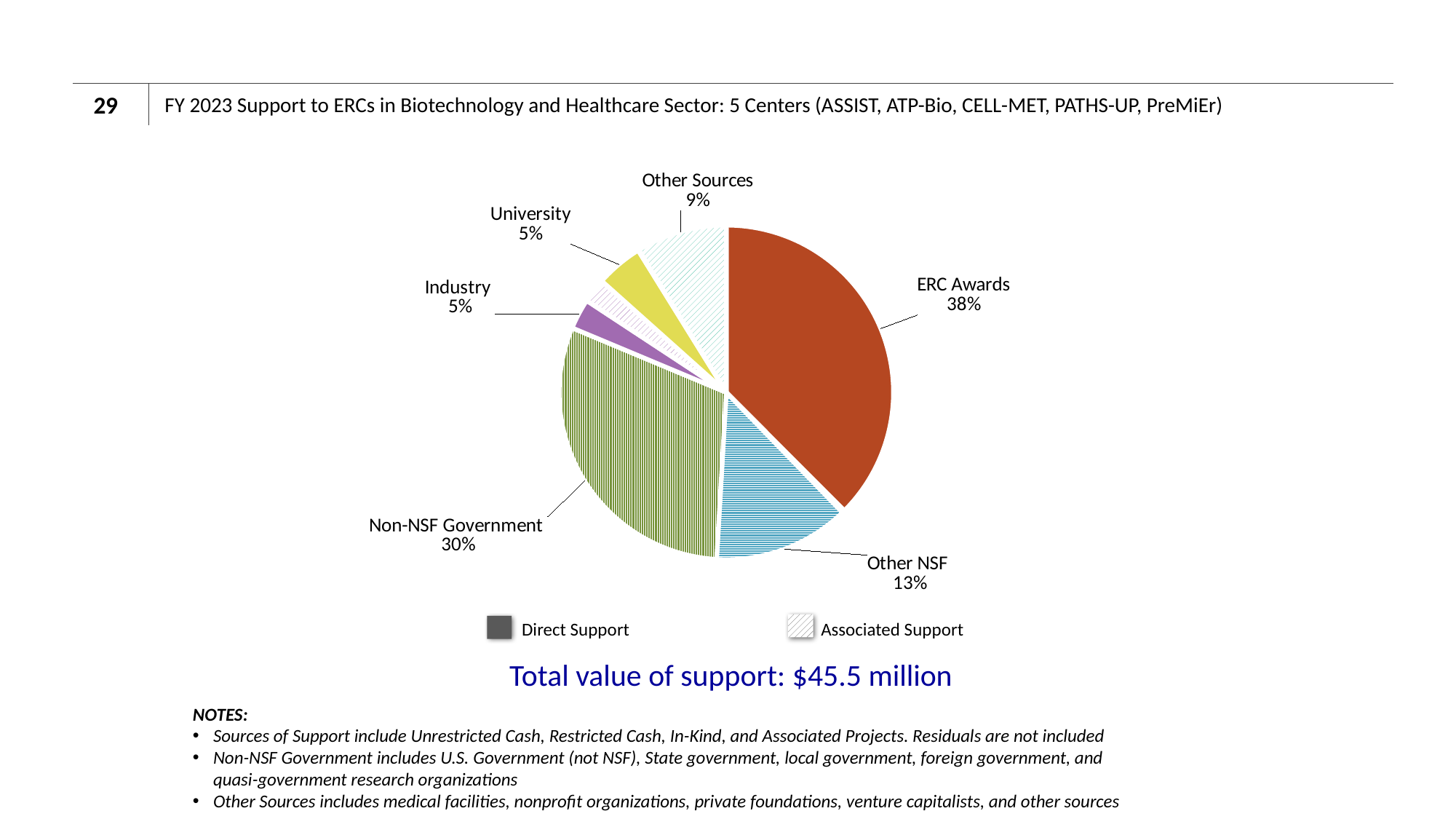
What two support types does the legend list? Direct Support and Associated Support Which is larger, Other NSF or Other Sources? Other NSF Which category has the largest slice of the pie? ERC Awards What is the difference in percentage points between ERC Awards and Non-NSF Government? 8 What percentage is shown for Other Sources? 9% What kind of chart is shown on the slide? Pie chart What percentage is shown for Other NSF? 13% What percentage is shown for Industry? 5% What share of the pie does ERC Awards represent? 38% What percentage is shown for Non-NSF Government? 30% What is the total value of support stated below the chart? $45.5 million How many categories are shown in the pie chart? 6